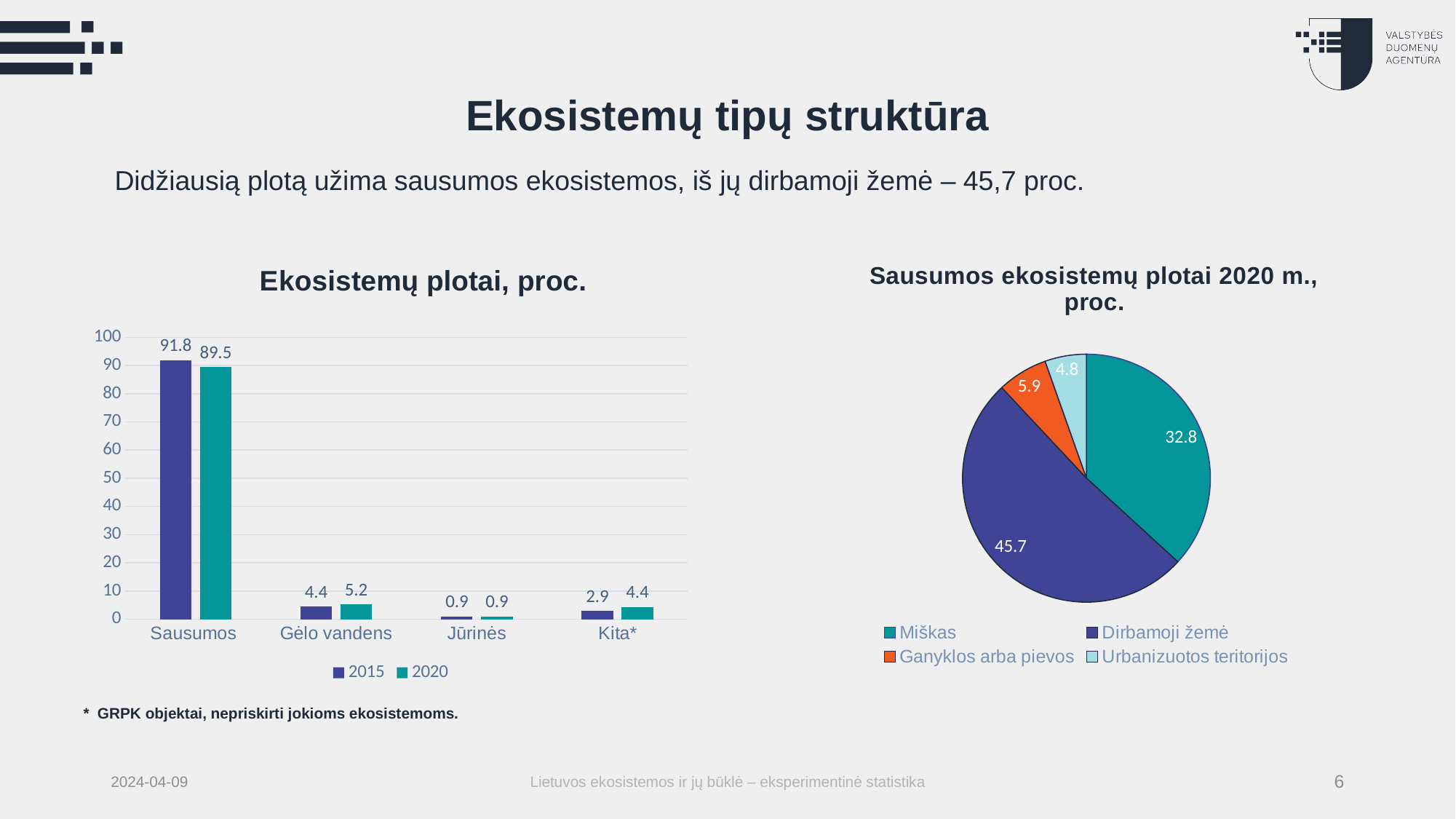
How many series does the legend of the chart 'Ekosistemų plotai, proc.' list? 2 In the chart 'Ekosistemų plotai, proc.', which category has the highest value in 2015? Sausumos In the chart 'Ekosistemų plotai, proc.', what is the value for Sausumos in 2020? 89.5 What kind of chart is 'Ekosistemų plotai, proc.'? Bar chart In the pie chart 'Sausumos ekosistemų plotai 2020 m., proc.', what is the difference between Ganyklos arba pievos and Urbanizuotos teritorijos? 1.1 In the chart 'Ekosistemų plotai, proc.', what is the value for Gėlo vandens in 2015? 4.4 In the pie chart 'Sausumos ekosistemų plotai 2020 m., proc.', which category has the largest slice? Dirbamoji žemė In the chart 'Ekosistemų plotai, proc.', is the value for Kita* larger in 2015 or in 2020? 2020 In the chart 'Ekosistemų plotai, proc.', which category has the lowest value in 2020? Jūrinės How many categories are shown on the x axis of the chart 'Ekosistemų plotai, proc.'? 4 In the chart 'Ekosistemų plotai, proc.', what is the difference between the 2015 and 2020 values for Sausumos? 2.3 In the pie chart 'Sausumos ekosistemų plotai 2020 m., proc.', what is the value for Miškas? 32.8